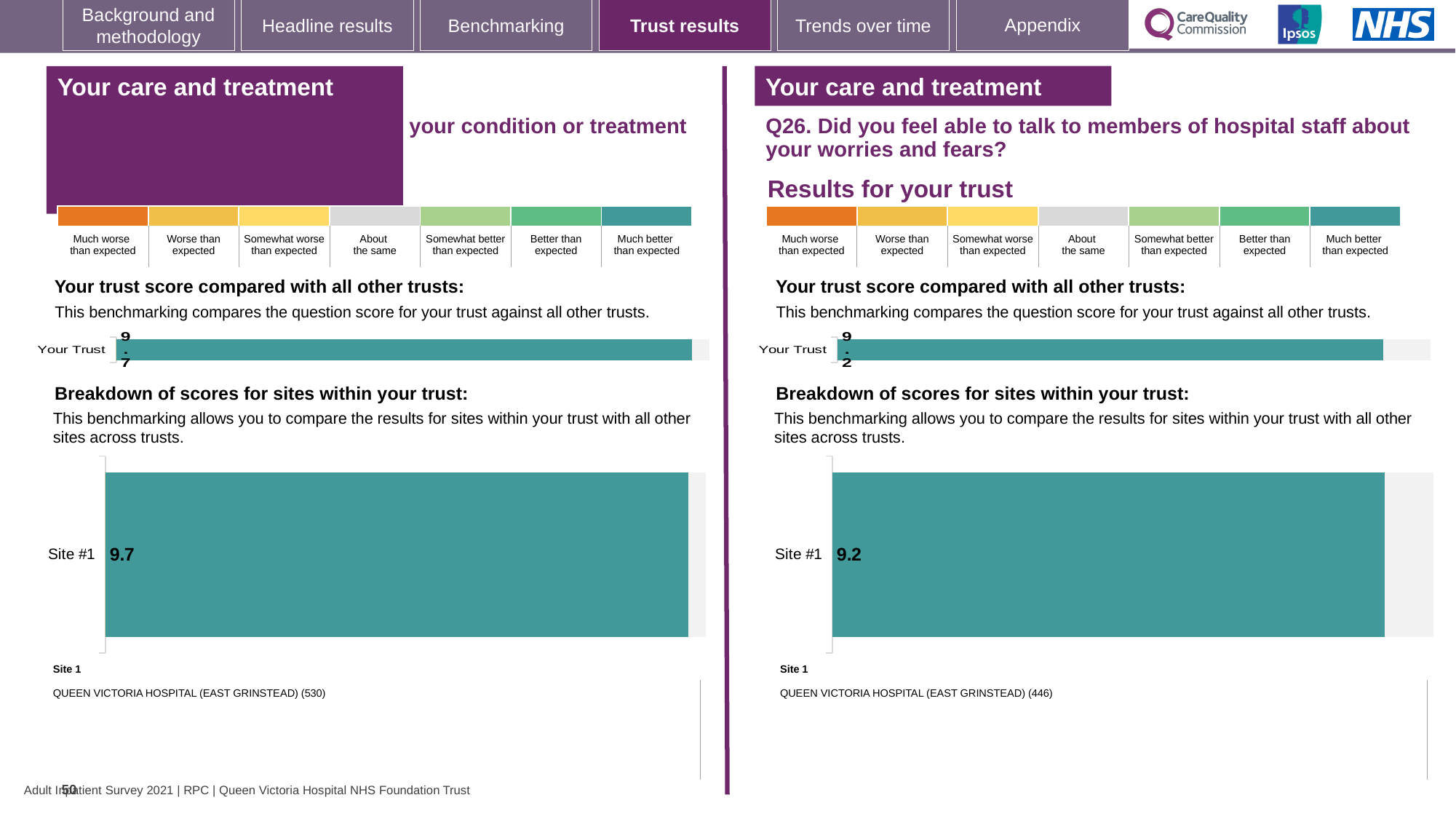
Which of the two Your Trust bars is longer: the left-hand one or the right-hand (Q26) one? Left-hand (9.7) What kind of chart is used to show the Site #1 score on the right-hand side of the slide? Bar chart On the left-hand 'Your trust score compared with all other trusts' chart, what is the value for Your Trust? 9.7 How many benchmark categories are shown in the coloured scale above the right-hand (Q26) charts? 7 On the left-hand 'Breakdown of scores for sites within your trust' chart, what is the score for Site #1? 9.7 What is the difference between the Your Trust score on the left-hand chart and the Your Trust score on the right-hand (Q26) chart? 0.5 On the right-hand 'Breakdown of scores for sites within your trust' chart (Q26), what is the score for Site #1? 9.2 How many sites are shown in the left-hand 'Breakdown of scores for sites within your trust' chart? 1 According to the text below the right-hand breakdown chart, which hospital is Site 1? QUEEN VICTORIA HOSPITAL (EAST GRINSTEAD) On the right-hand 'Your trust score compared with all other trusts' chart (Q26), what is the value for Your Trust? 9.2 Which Site #1 score is larger: the one on the left-hand breakdown chart or the one on the right-hand (Q26) breakdown chart? Left-hand chart (9.7)